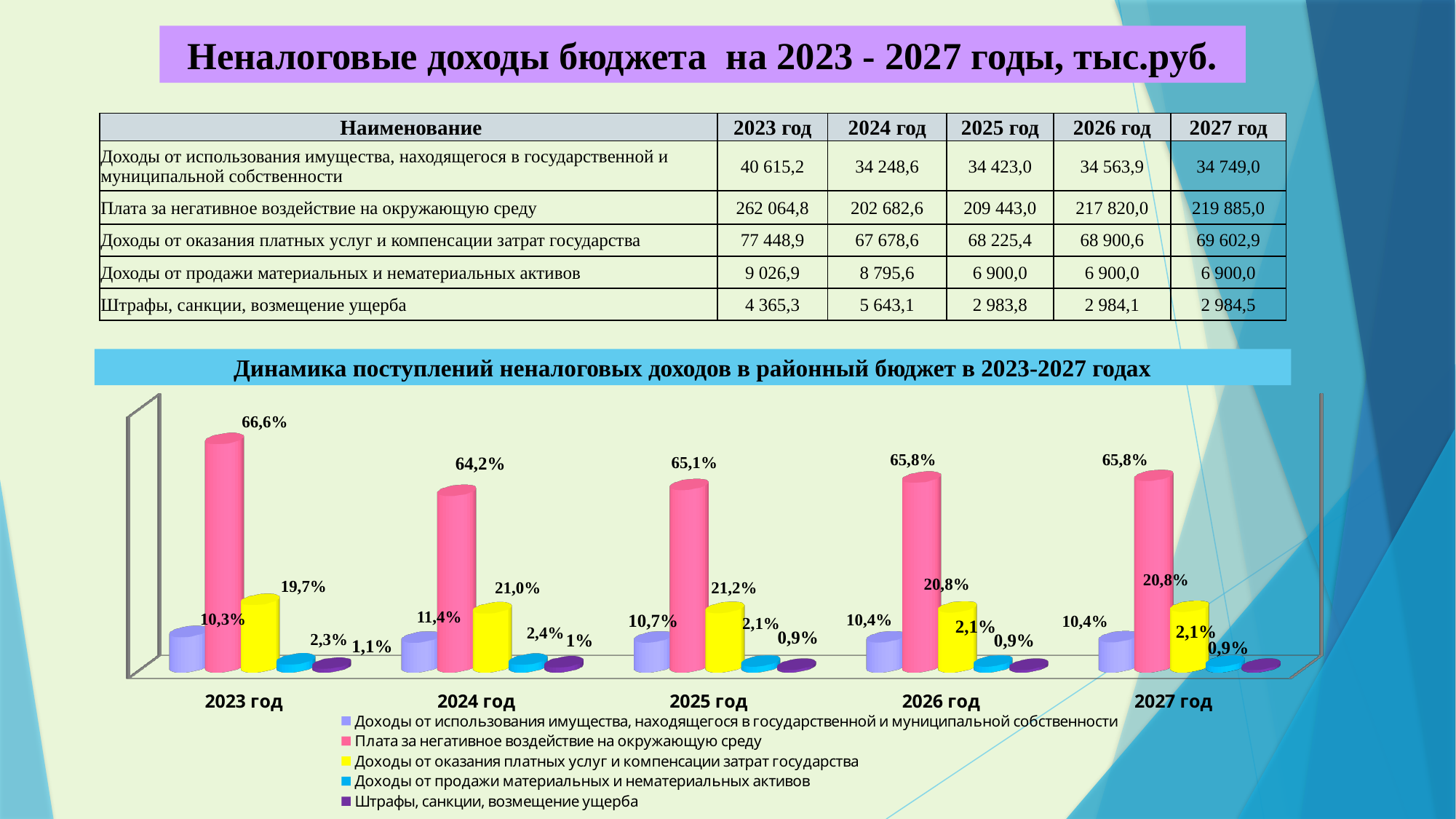
What type of chart is shown under the title 'Динамика поступлений неналоговых доходов в районный бюджет в 2023-2027 годах'? bar chart In the chart, what is the difference between the 'Плата за негативное воздействие на окружающую среду' values for 2023 год and 2024 год? 2,4% In the chart, what is the value for 'Плата за негативное воздействие на окружающую среду' in 2023 год? 66,6% How many year categories are shown on the x axis of the chart? 5 How many series does the chart legend list? 5 In the chart, which is larger for 2023 год: 'Доходы от использования имущества, находящегося в государственной и муниципальной собственности' or 'Доходы от оказания платных услуг и компенсации затрат государства'? Доходы от оказания платных услуг и компенсации затрат государства In the chart, what is the value for 'Доходы от оказания платных услуг и компенсации затрат государства' in 2025 год? 21,2% In which year is the value for 'Плата за негативное воздействие на окружающую среду' the lowest in the chart? 2024 год What colour are the bars for 'Плата за негативное воздействие на окружающую среду' in the chart? pink In the chart, what is the value for 'Доходы от использования имущества, находящегося в государственной и муниципальной собственности' in 2024 год? 11,4% In which year is the value for 'Плата за негативное воздействие на окружающую среду' the highest in the chart? 2023 год In the chart, what is the value for 'Штрафы, санкции, возмещение ущерба' in 2027 год? 0,9%